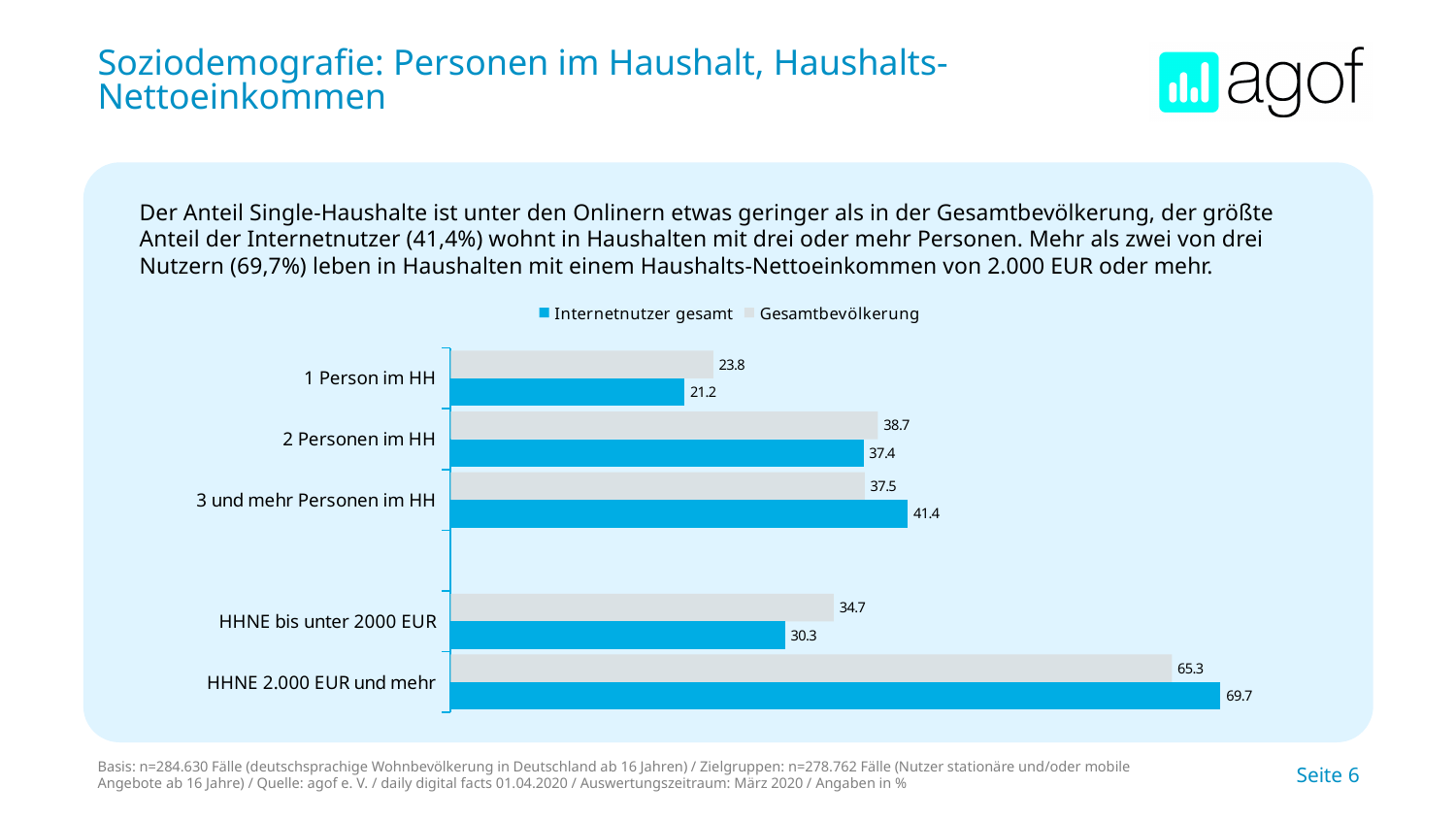
Which category has the highest value for Internetnutzer gesamt? HHNE 2.000 EUR und mehr What is the difference between the Gesamtbevölkerung and Internetnutzer gesamt values for "HHNE bis unter 2000 EUR"? 4.4 What is the value for Internetnutzer gesamt in the category "3 und mehr Personen im HH"? 41.4 What is the value for Internetnutzer gesamt in the category "1 Person im HH"? 21.2 How many series does the legend list? 2 In the category "3 und mehr Personen im HH", which series has the larger value, Internetnutzer gesamt or Gesamtbevölkerung? Internetnutzer gesamt What kind of chart is shown on the slide? Bar chart What is the difference between the Internetnutzer gesamt and Gesamtbevölkerung values for "HHNE 2.000 EUR und mehr"? 4.4 How many labelled categories are shown on the chart? 5 What is the value for Gesamtbevölkerung in the category "HHNE 2.000 EUR und mehr"? 65.3 What is the value for Gesamtbevölkerung in the category "HHNE bis unter 2000 EUR"? 34.7 Which category has the lowest value for Gesamtbevölkerung? 1 Person im HH